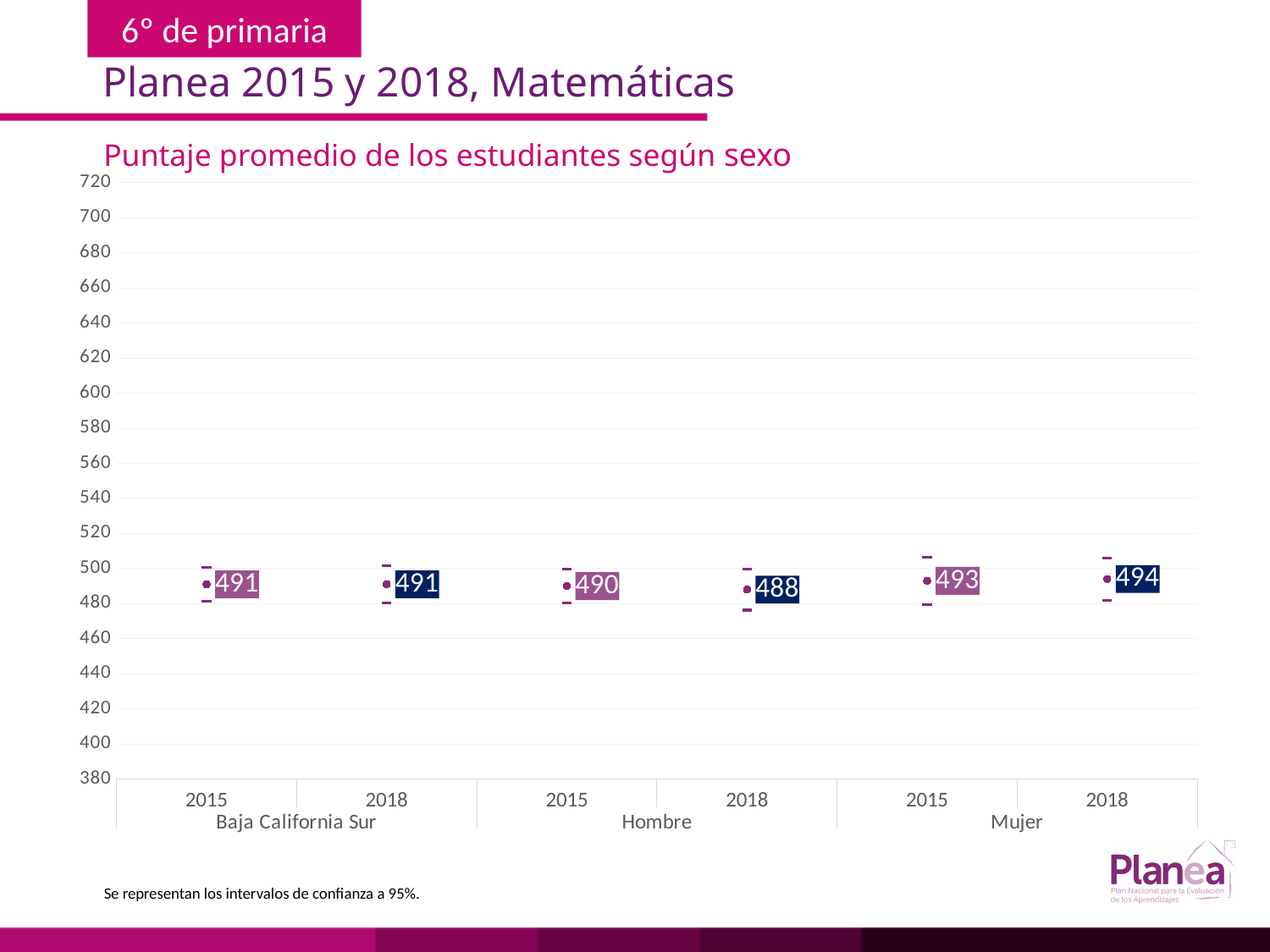
How many data points are plotted on the chart? 6 Is the value for Mujer in 2018 greater or less than 500? less What is the difference between the 2018 scores for Mujer and Hombre? 6 Did the Hombre score rise or fall from 2015 to 2018? fall What is the average score for Mujer in 2018? 494 What is the average score for Hombre in 2018? 488 Which group and year has the lowest average score? Hombre 2018 What is the title of the chart? Puntaje promedio de los estudiantes según sexo What is the average score for Baja California Sur in 2015? 491 Which group and year has the highest average score? Mujer 2018 What is the difference between the 2015 scores for Mujer and Hombre? 3 Which is larger, the Hombre score in 2015 or in 2018? 2015